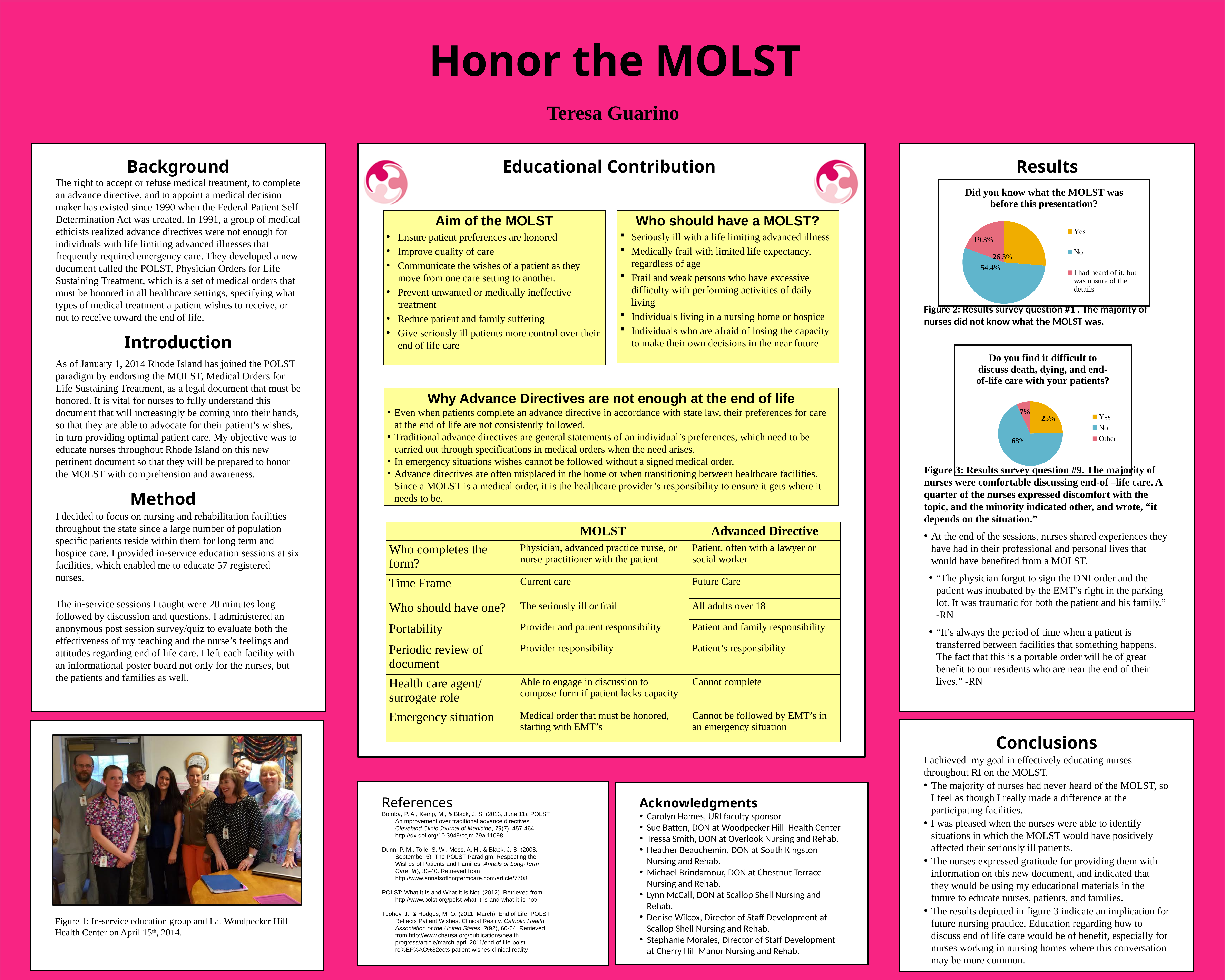
In the pie chart titled "Did you know what the MOLST was before this presentation?", what share of nurses said they had heard of it but were unsure of the details? 19.3% In the pie chart titled "Do you find it difficult to discuss death, dying, and end-of-life care with your patients?", what share of nurses answered "Other"? 7% In the pie chart titled "Do you find it difficult to discuss death, dying, and end-of-life care with your patients?", which response has the smallest share? Other In the pie chart titled "Do you find it difficult to discuss death, dying, and end-of-life care with your patients?", what share of nurses answered "Yes"? 25% What type of chart is used in the Results section to show the survey responses? Pie chart In the pie chart titled "Do you find it difficult to discuss death, dying, and end-of-life care with your patients?", what is the difference between the "No" and "Yes" shares? 43% In the pie chart titled "Did you know what the MOLST was before this presentation?", what share of nurses answered "No"? 54.4% In the pie chart titled "Did you know what the MOLST was before this presentation?", how many response categories does the legend list? 3 In the pie chart titled "Do you find it difficult to discuss death, dying, and end-of-life care with your patients?", what share of nurses answered "No"? 68% In the pie chart titled "Did you know what the MOLST was before this presentation?", which response has the largest share? No In the pie chart titled "Did you know what the MOLST was before this presentation?", what share of nurses answered "Yes"? 26.3% In the pie chart titled "Did you know what the MOLST was before this presentation?", which response has the smallest share? I had heard of it, but was unsure of the details